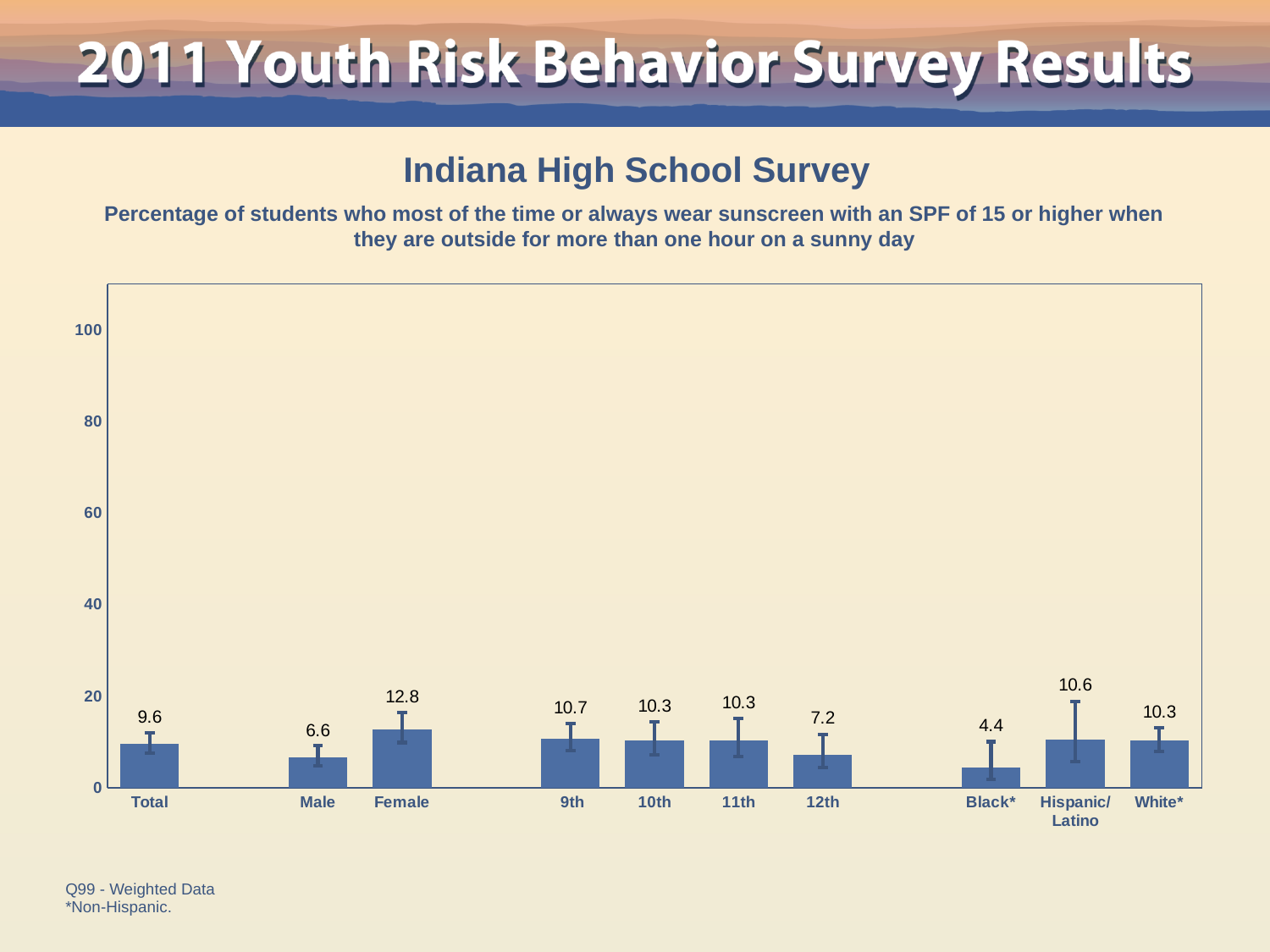
What is the value for 12th? 7.2 Which is larger, the value for Hispanic/Latino or the value for Black*? Hispanic/Latino Which category has the lowest value? Black* Which category has the highest value? Female What is the value for Black*? 4.4 What is the value for Total? 9.6 Do the values rise or fall from 9th to 12th grade? fall What is the value for Female? 12.8 What kind of chart is shown? bar chart Is the value for Female greater or less than 20? less How many categories are shown on the x axis? 10 What is the difference between the values for Female and Male? 6.2